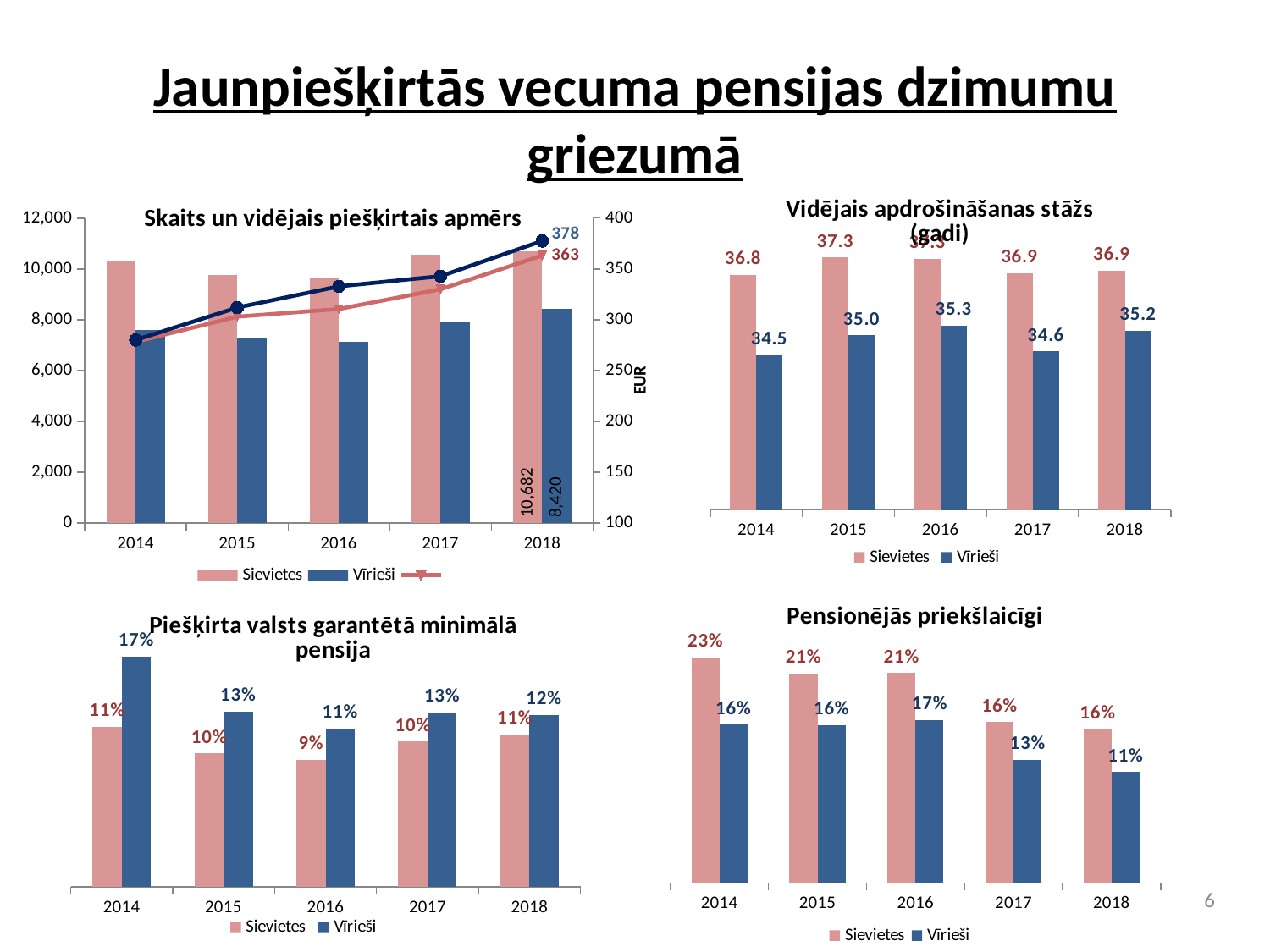
In the chart 'Skaits un vidējais piešķirtais apmērs', what is the difference between the Sievietes and Vīrieši bar values in 2018? 2,262 In the chart 'Vidējais apdrošināšanas stāžs (gadi)', what is the value for Sievietes in 2015? 37.3 In the chart 'Skaits un vidējais piešķirtais apmērs', what is the value for Vīrieši in 2018? 8,420 How many years are shown on the x axis of the chart 'Pensionējās priekšlaicīgi'? 5 In the chart 'Pensionējās priekšlaicīgi', what is the value for Sievietes in 2014? 23% In the chart 'Piešķirta valsts garantētā minimālā pensija', which year has the lowest value for Sievietes? 2016 In the chart 'Vidējais apdrošināšanas stāžs (gadi)', which year has the lowest value for Vīrieši? 2014 In the chart 'Vidējais apdrošināšanas stāžs (gadi)', what is the value for Vīrieši in 2016? 35.3 In the chart 'Pensionējās priekšlaicīgi', what is the difference between Sievietes and Vīrieši in 2018? 5% In the chart 'Piešķirta valsts garantētā minimālā pensija', what is the value for Vīrieši in 2014? 17% In the chart 'Skaits un vidējais piešķirtais apmērs', what is the value for Sievietes in 2018? 10,682 In the chart 'Pensionējās priekšlaicīgi', do the values for Vīrieši rise or fall from 2016 to 2018? fall